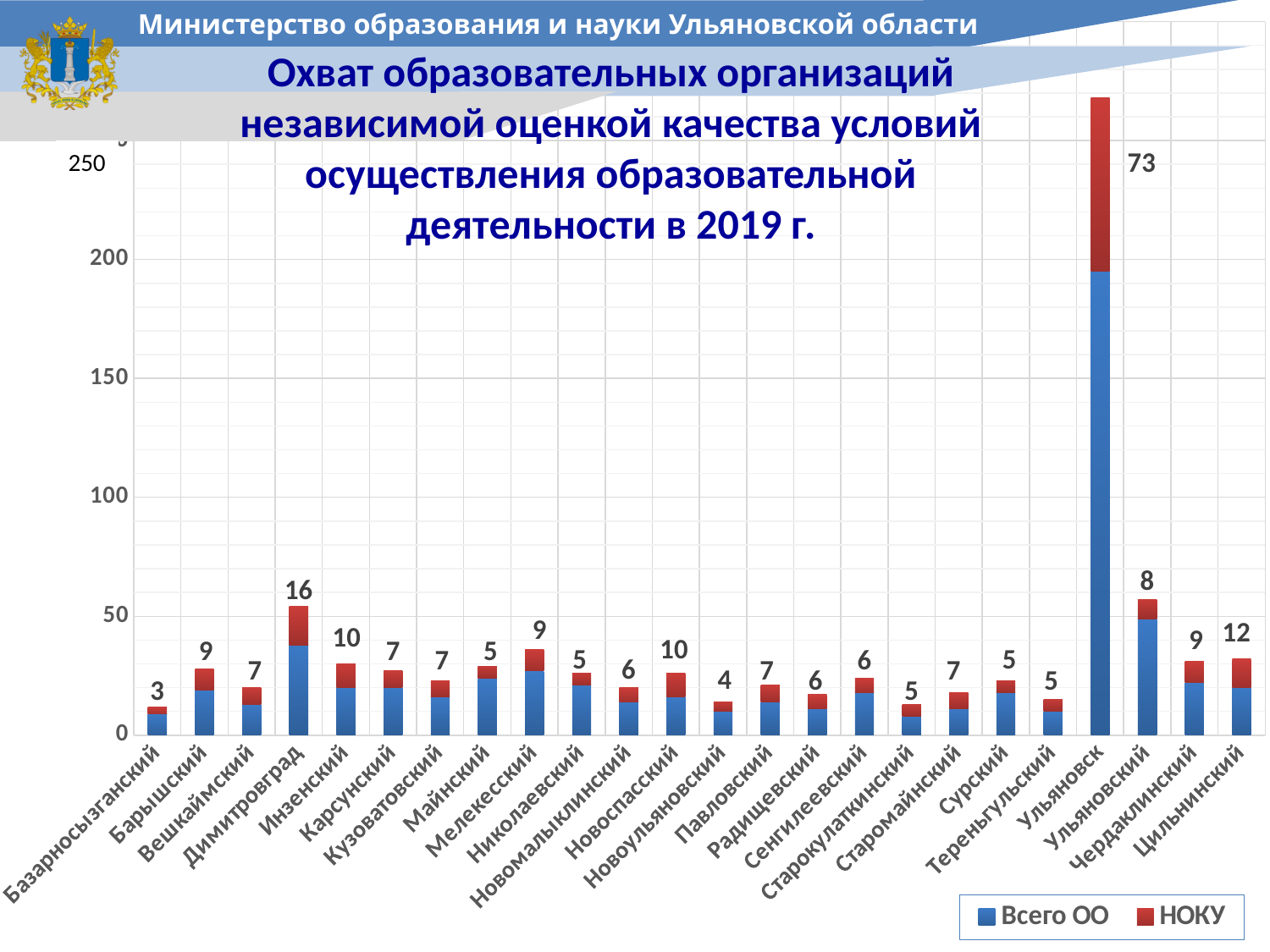
What kind of chart is shown on the slide? Stacked bar chart What is the НОКУ value for Ульяновск? 73 Which series is shown in red in the legend? НОКУ What is the НОКУ value for Цильнинский? 12 Is the Всего ОО value for Ульяновск greater or less than 150? greater What is the НОКУ value for Димитровград? 16 How many series does the legend list? 2 Which category has the lowest НОКУ value? Базарносызганский How many categories are shown on the x axis? 24 What is the difference between the НОКУ values for Ульяновск and Димитровград? 57 Which has a larger НОКУ value, Инзенский or Майнский? Инзенский Which category has the highest НОКУ value? Ульяновск